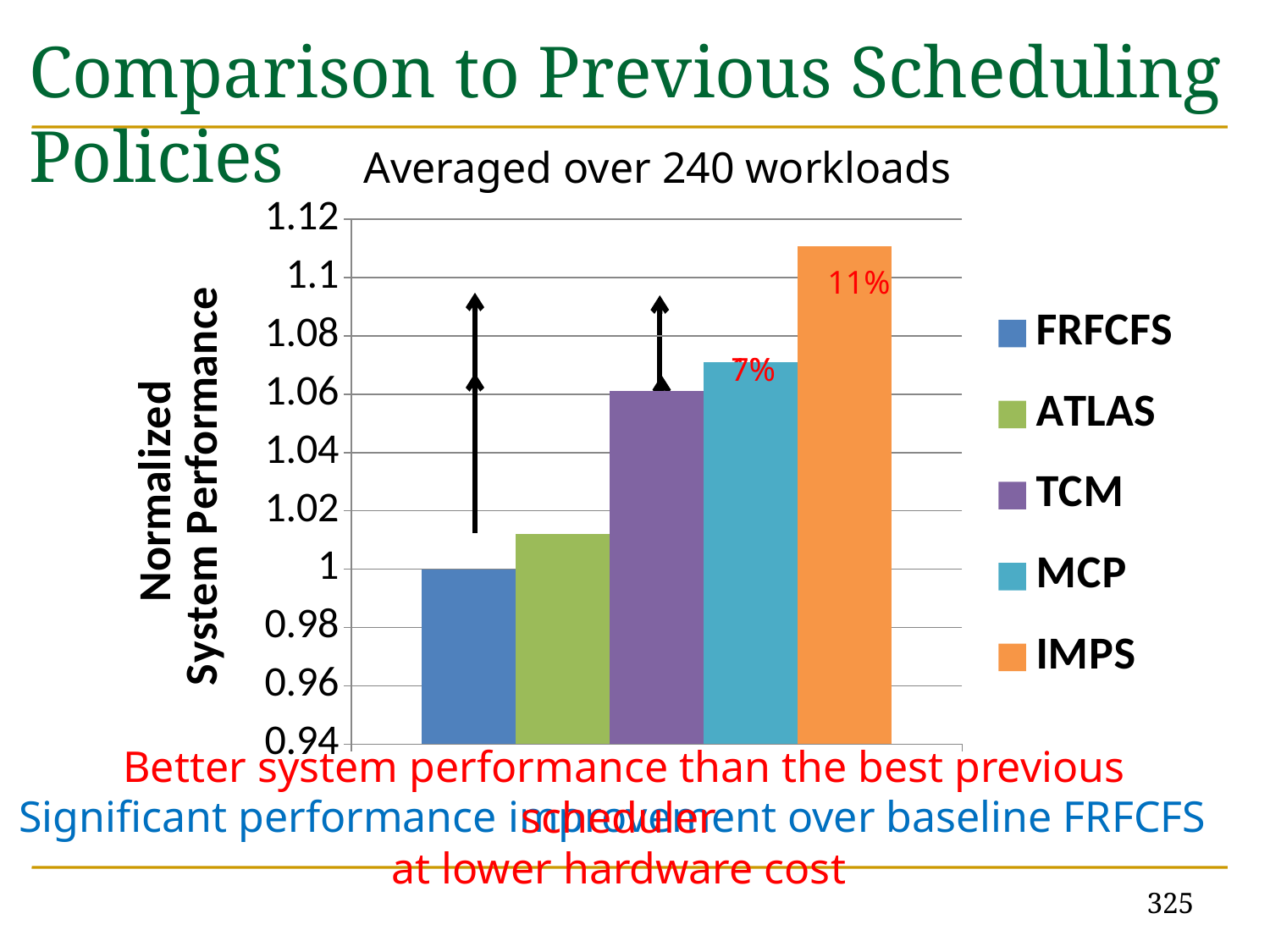
Which scheduling policy has the highest normalized system performance? IMPS Is the value for ATLAS greater or less than 1.02? less What is the normalized system performance value for FRFCFS? 1 What is the title of the chart? Averaged over 240 workloads Which scheduling policy has the lowest normalized system performance? FRFCFS Is the value for IMPS greater or less than 1.1? greater What is the label on the vertical axis of the chart? Normalized System Performance Is the value for TCM greater or less than 1.04? greater Which has a higher normalized system performance, IMPS or MCP? IMPS How many series does the legend list? 5 What kind of chart is shown on the slide? bar chart